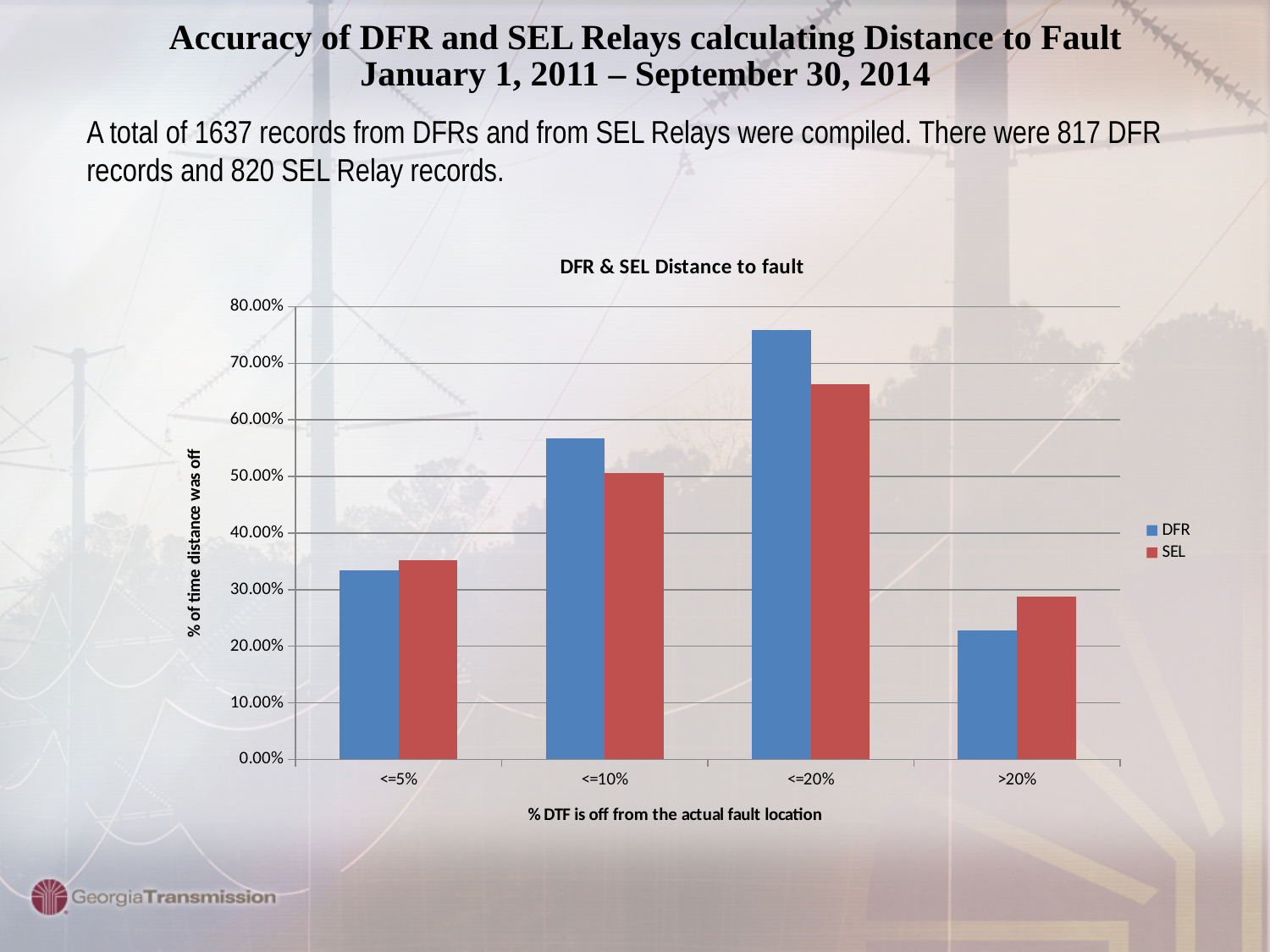
What is the title of the chart? DFR & SEL Distance to fault Is the DFR value for <=20% greater or less than 70.00%? greater Which category has the lowest DFR value? >20% How many series does the legend list? 2 How many categories are shown on the x axis? 4 Which category has the lowest SEL value? >20% Is the SEL value for >20% greater or less than 30.00%? less For the <=10% category, which series has the larger value, DFR or SEL? DFR What type of chart is shown on the slide? bar chart For the >20% category, which series has the larger value, DFR or SEL? SEL Which category has the highest DFR value? <=20% Is the DFR value for <=10% greater or less than 50.00%? greater